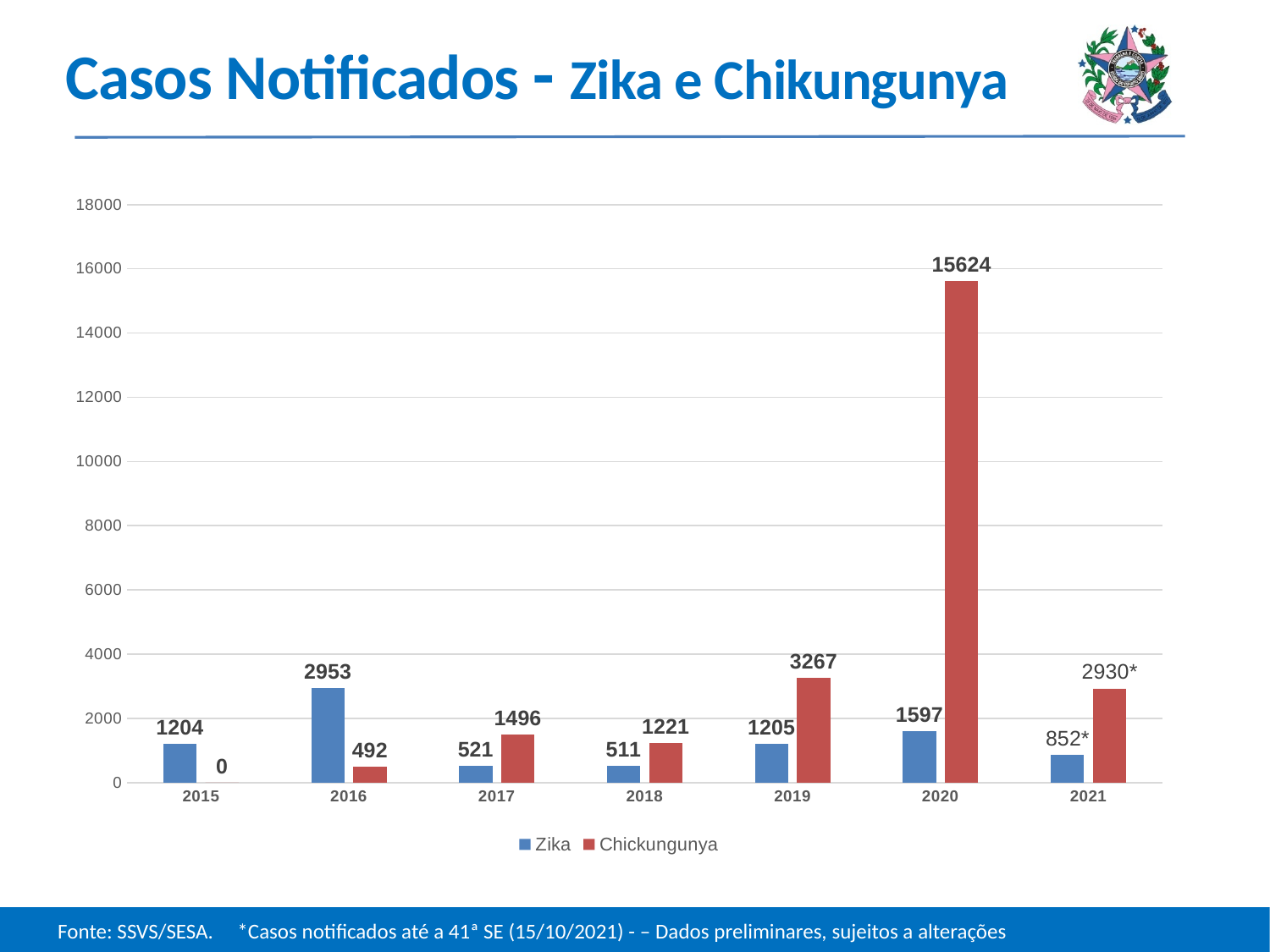
Which is larger in 2017, the Zika value or the Chickungunya value? Chickungunya How many years are shown on the x axis? 7 What is the value shown for Zika in 2021? 852* What is the difference between the Chickungunya and Zika values in 2019? 2062 How many series does the legend list? 2 Is the Chickungunya value for 2020 greater or less than 14000? greater What kind of chart is shown on the slide? Bar chart What is the value shown for Chickungunya in 2015? 0 In which year is the Chickungunya value highest? 2020 In which year is the Zika value lowest? 2018 What is the number of Chickungunya cases notified in 2020? 15624 What is the number of Zika cases notified in 2016? 2953